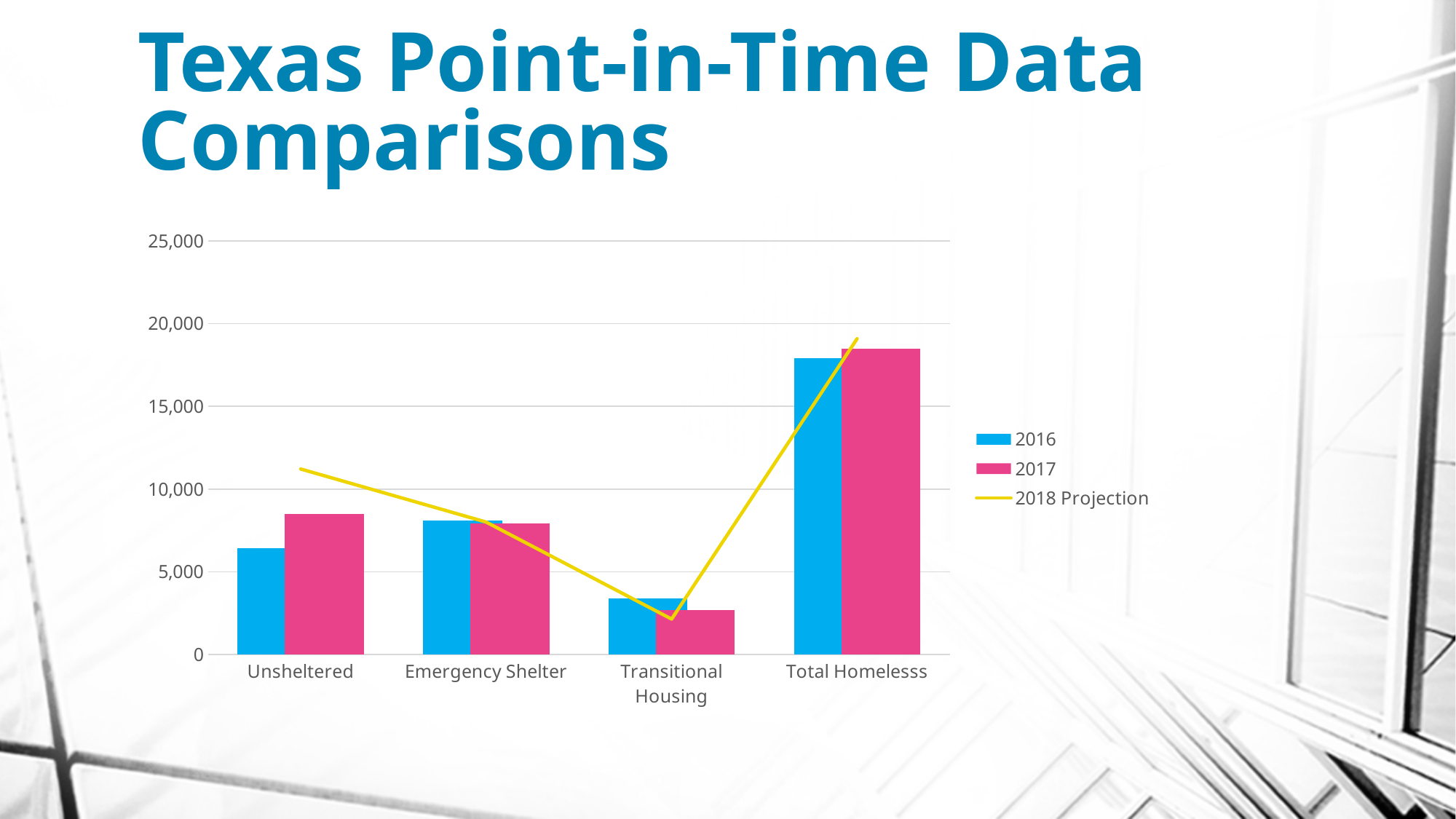
What kind of chart is shown on the slide? bar chart with a line Is the 2018 Projection value for Unsheltered greater or less than 10,000? greater For Transitional Housing, which is larger: the 2016 value or the 2017 value? 2016 What colour represents the 2018 Projection series in the legend? yellow Is the 2017 value for Transitional Housing greater or less than 5,000? less Which category has the lowest 2017 value? Transitional Housing Which category has the highest 2016 value? Total Homelesss For Unsheltered, which is larger: the 2016 value or the 2017 value? 2017 How many series does the legend list? 3 Is the 2016 value for Total Homelesss greater or less than 15,000? greater How many categories are shown on the x axis? 4